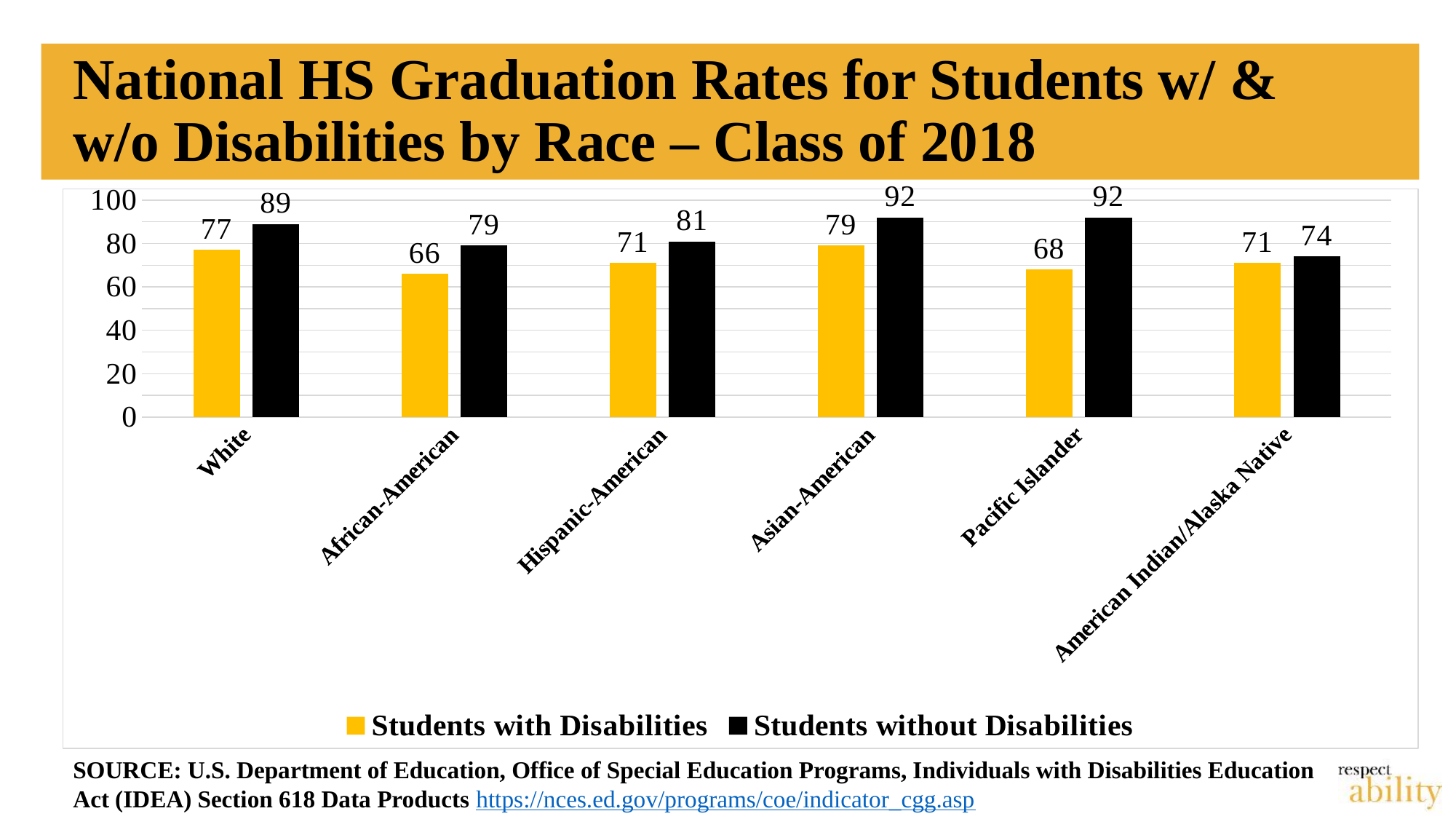
Which race category has the lowest graduation rate for students with disabilities? African-American What is the graduation rate for Asian-American students without disabilities? 92 What is the difference between the graduation rates of White students without disabilities and White students with disabilities? 12 What is the graduation rate for African-American students with disabilities? 66 Which race category has the highest graduation rate for students with disabilities? Asian-American What is the difference between the graduation rates of Pacific Islander students without disabilities and with disabilities? 24 How many race categories are shown on the x axis? 6 Which is larger: the graduation rate for Hispanic-American students with disabilities or for Pacific Islander students with disabilities? Hispanic-American students with disabilities What is the graduation rate for White students with disabilities? 77 What kind of chart is shown on the slide? Bar chart How many series does the legend list? 2 Which race category has the lowest graduation rate for students without disabilities? American Indian/Alaska Native